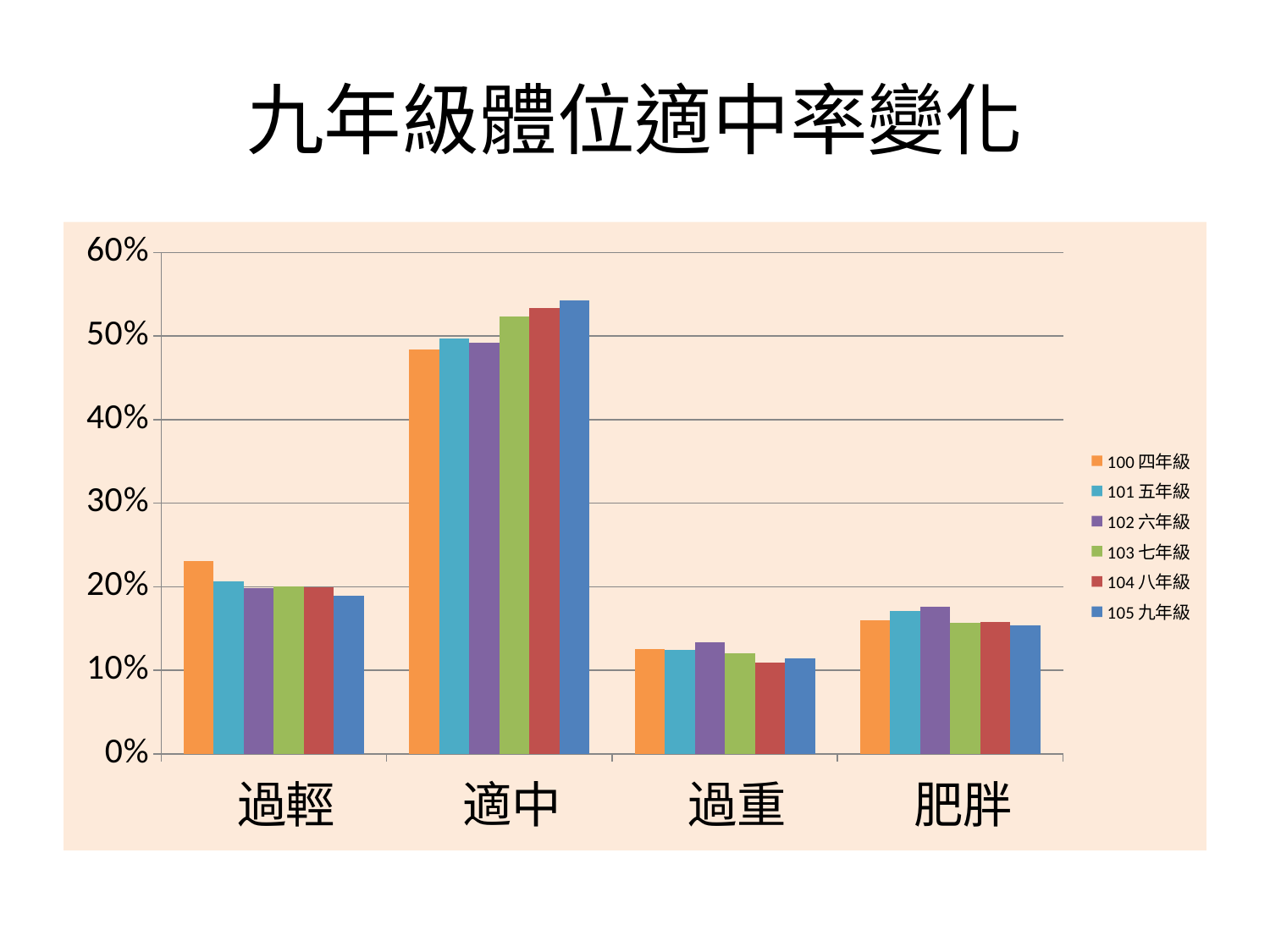
Within the 過輕 category, which series has the highest bar? 100 四年級 Within the 適中 category, which series has the highest bar? 105 九年級 Which category has the highest values across all series? 適中 Is the value for 104 八年級 in the 過重 category greater or less than 20%? less Which is larger for 100 四年級: the value in 過輕 or the value in 肥胖? 過輕 What kind of chart is shown on the slide? bar chart What is the title of the chart? 九年級體位適中率變化 How many categories are shown on the x axis? 4 Is the value for 105 九年級 in the 適中 category greater or less than 50%? greater Is the value for 100 四年級 in the 過輕 category greater or less than 20%? greater How many series does the legend list? 6